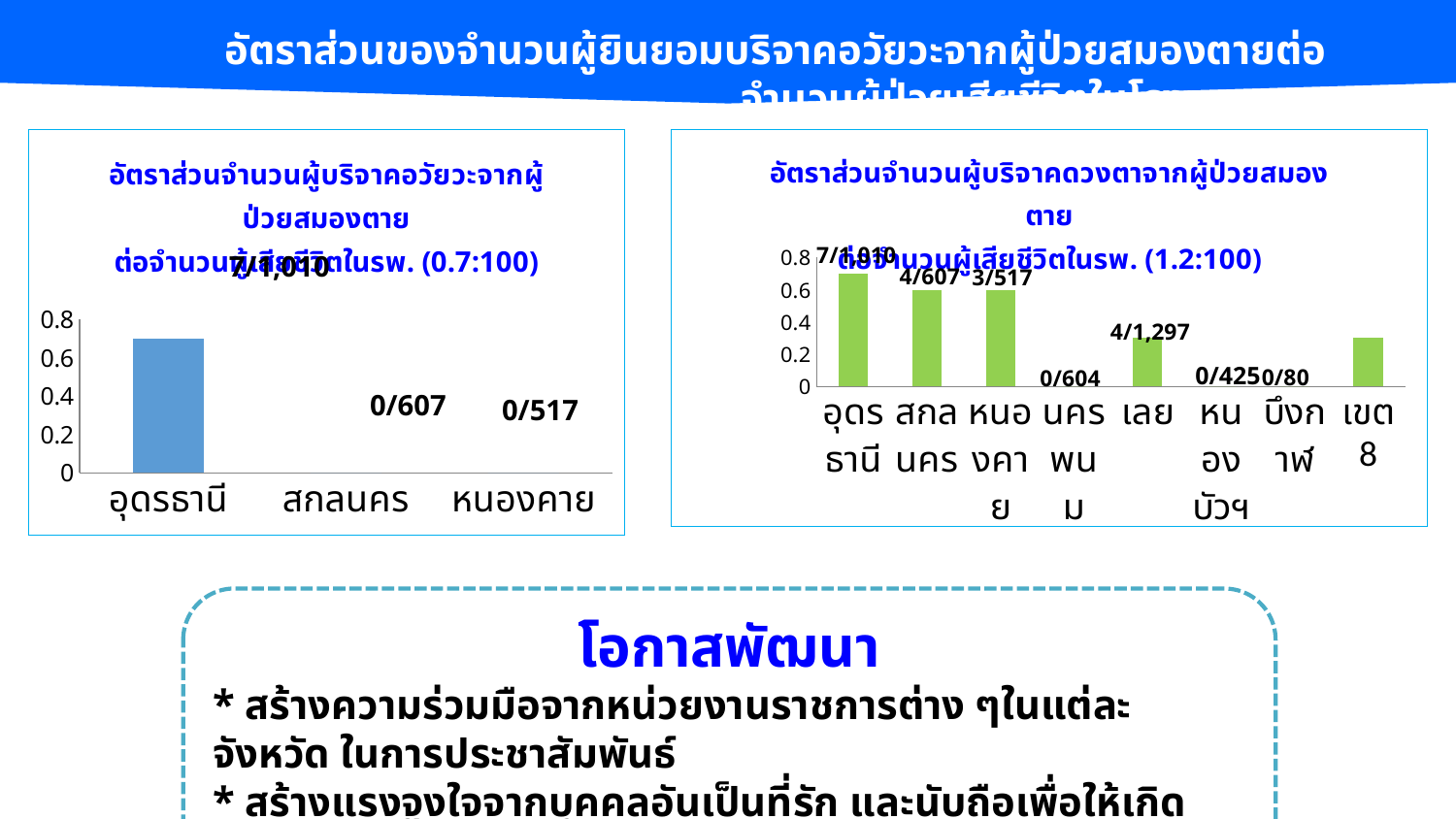
In the right chart (อัตราส่วนจำนวนผู้บริจาคดวงตาจากผู้ป่วยสมองตาย), what data label is shown for เลย? 4/1,297 How many categories are shown on the x axis of the right chart (อัตราส่วนจำนวนผู้บริจาคดวงตาจากผู้ป่วยสมองตาย)? 8 In the right chart (อัตราส่วนจำนวนผู้บริจาคดวงตาจากผู้ป่วยสมองตาย), which has the larger value, สกลนคร or เลย? สกลนคร In the left chart (อัตราส่วนจำนวนผู้บริจาคอวัยวะจากผู้ป่วยสมองตาย), is the value for อุดรธานี greater or less than 0.6? greater What type of chart is the left chart (อัตราส่วนจำนวนผู้บริจาคอวัยวะจากผู้ป่วยสมองตาย)? bar chart In the right chart (อัตราส่วนจำนวนผู้บริจาคดวงตาจากผู้ป่วยสมองตาย), which category has the highest bar? อุดรธานี In the left chart (อัตราส่วนจำนวนผู้บริจาคอวัยวะจากผู้ป่วยสมองตาย), what data label is shown for สกลนคร? 0/607 In the right chart (อัตราส่วนจำนวนผู้บริจาคดวงตาจากผู้ป่วยสมองตาย), is the value for เลย greater or less than 0.4? less How many provinces are shown on the x axis of the left chart (อัตราส่วนจำนวนผู้บริจาคอวัยวะจากผู้ป่วยสมองตาย)? 3 In the left chart (อัตราส่วนจำนวนผู้บริจาคอวัยวะจากผู้ป่วยสมองตาย), which province has the highest bar? อุดรธานี In the right chart (อัตราส่วนจำนวนผู้บริจาคดวงตาจากผู้ป่วยสมองตาย), what data label is shown for นครพนม? 0/604 In the left chart (อัตราส่วนจำนวนผู้บริจาคอวัยวะจากผู้ป่วยสมองตาย), what data label is shown for อุดรธานี? 7/1,010